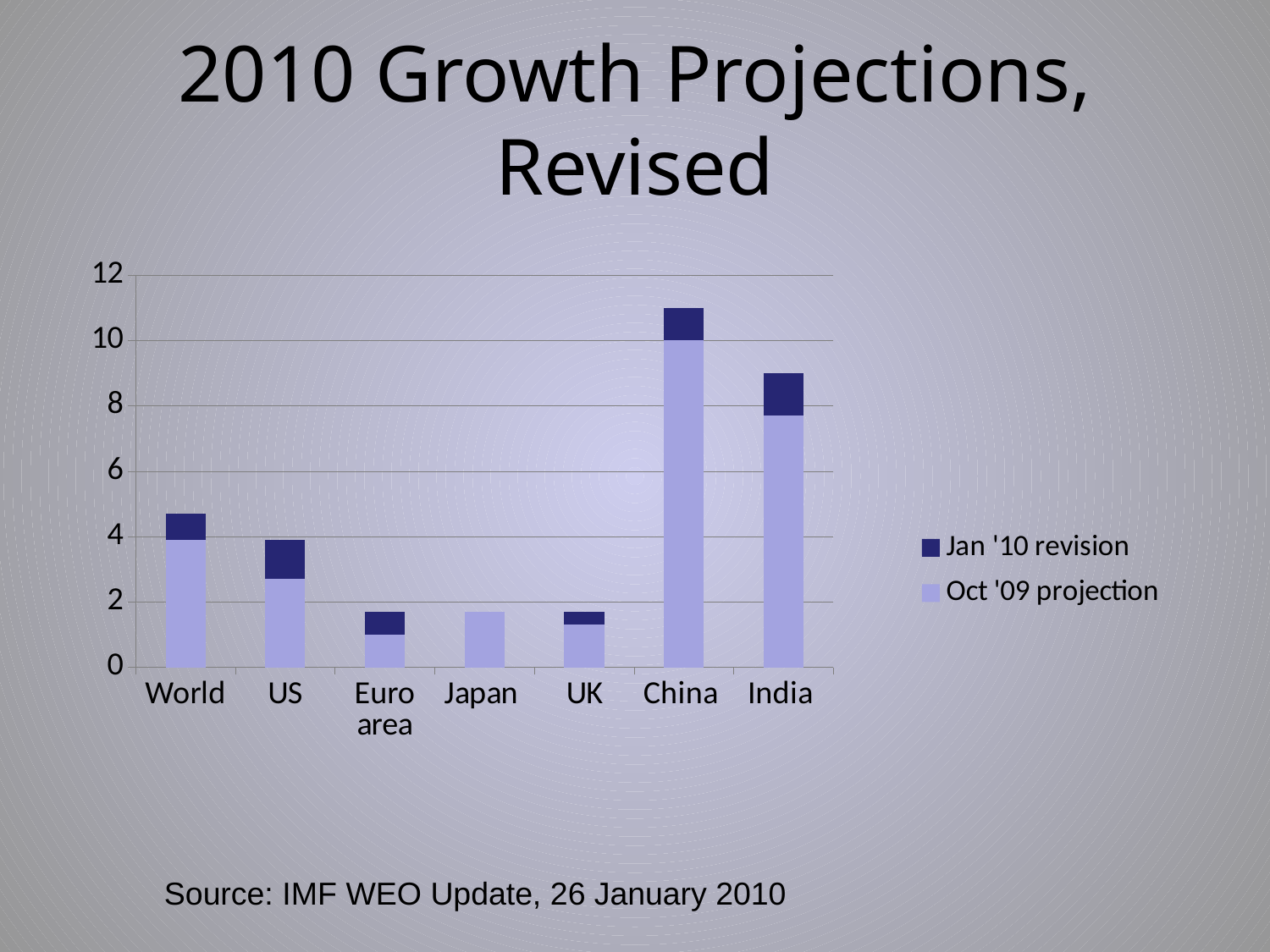
What kind of chart is shown on the slide? bar chart Which has the larger total bar, China or India? China Is the Oct '09 projection for India greater or less than 6? greater Which has the larger total bar, World or US? World What are the two series named in the chart's legend? Jan '10 revision and Oct '09 projection How many series does the chart's legend list? 2 Is the total bar for India greater or less than 8? greater How many categories are shown on the x axis of the chart? 7 Is the total bar for Euro area greater or less than 2? less What is the title of the chart on the slide? 2010 Growth Projections, Revised Which category has the highest total bar in the chart? China